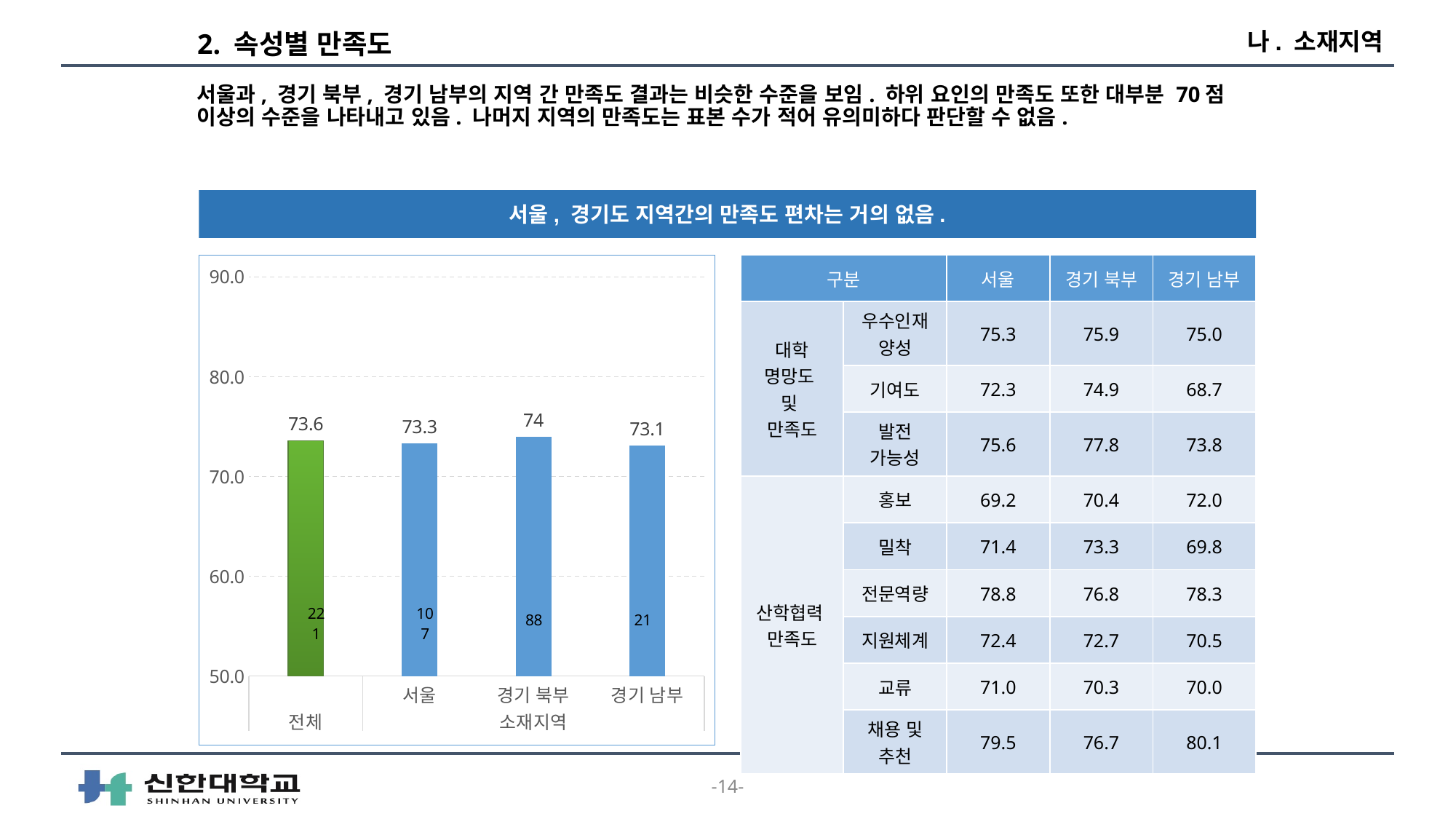
What is the value shown for 서울 in the chart? 73.3 Which category has the lowest value in the chart? 경기 남부 What colour is the 전체 bar in the chart? green What number is printed inside the 전체 bar? 221 What is the value shown for 전체 in the chart? 73.6 What is the difference between the values for 경기 북부 and 경기 남부? 0.9 Which category has the highest value in the chart? 경기 북부 What type of chart is shown on the slide? bar chart How many bars are plotted in the chart? 4 Is the value for 서울 greater or less than 80.0? less What is the value shown for 경기 북부 in the chart? 74 What is the value shown for 경기 남부 in the chart? 73.1